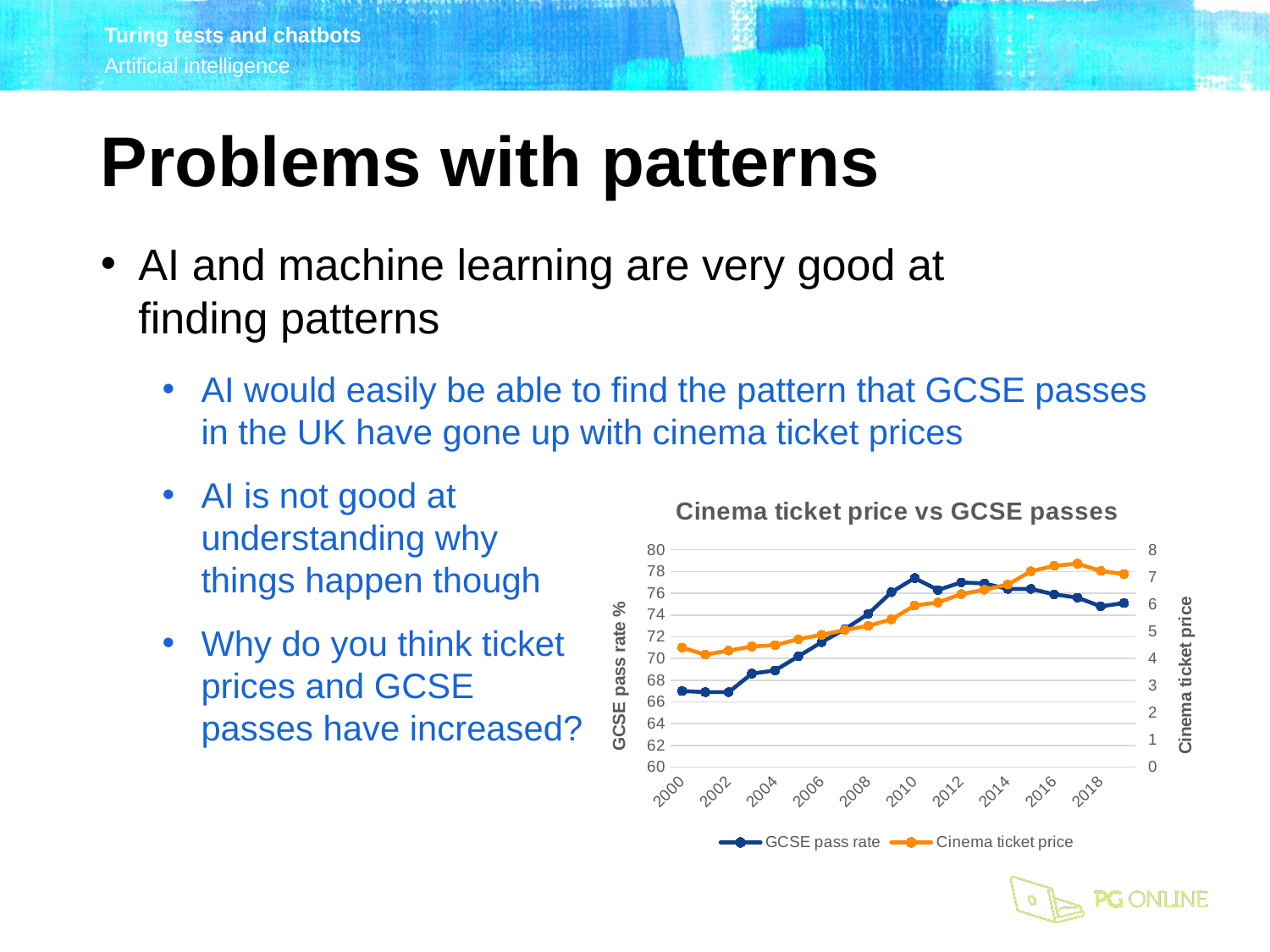
Is the GCSE pass rate in 2010 greater or less than 76? greater What is the label on the left vertical axis of the chart? GCSE pass rate % Does the GCSE pass rate rise or fall between 2000 and 2010? Rise What type of chart is shown on the slide? Line chart How many series does the chart legend list? 2 Is the GCSE pass rate in 2000 greater or less than 70? less Is the GCSE pass rate in 2004 greater or less than 70? less What is the title of the chart? Cinema ticket price vs GCSE passes Does the cinema ticket price generally rise or fall between 2000 and 2016? Rise